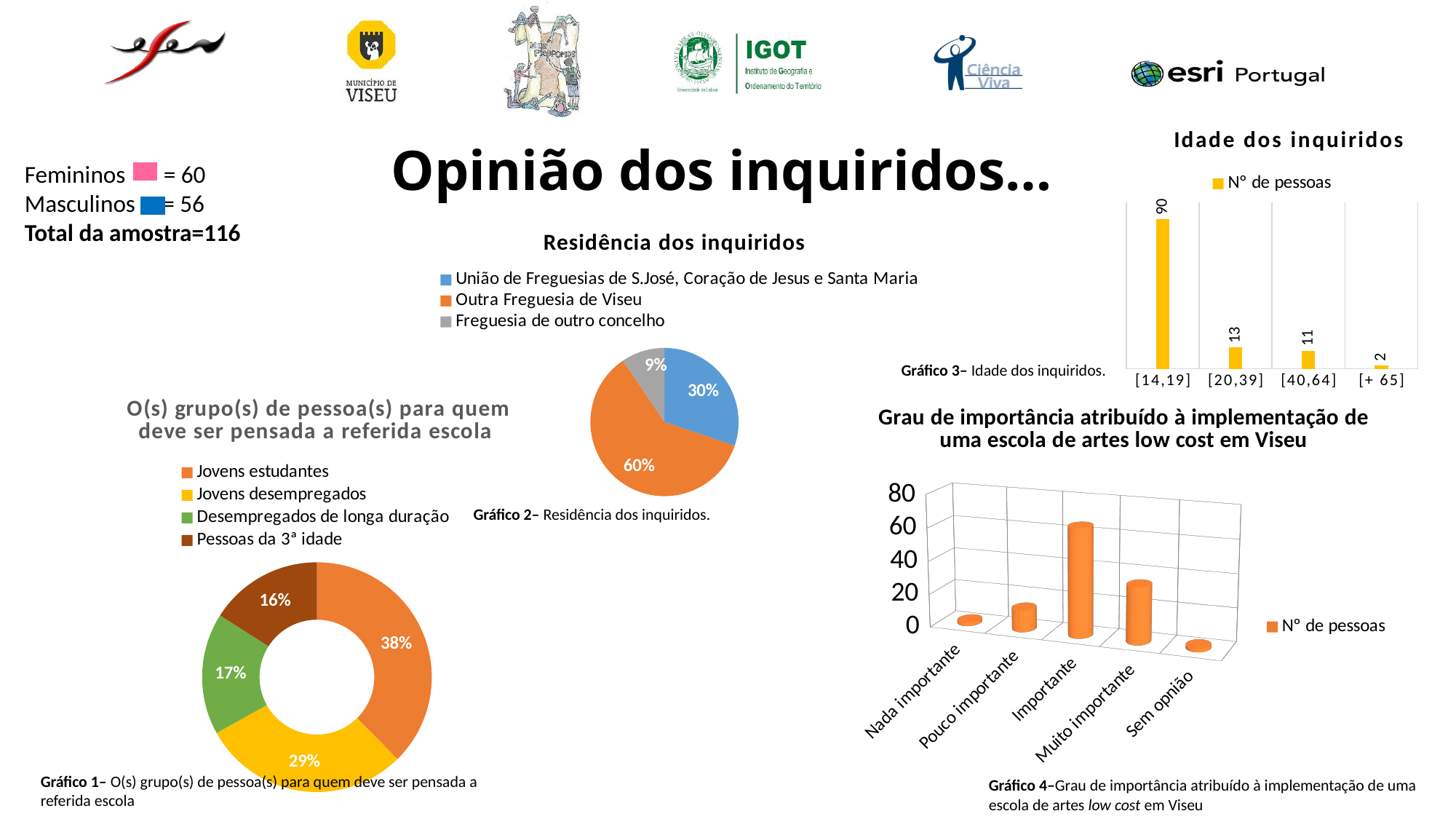
In the 'Grau de importância' chart, is the value for 'Importante' greater or less than 40? greater In the donut chart 'O(s) grupo(s) de pessoa(s) para quem deve ser pensada a referida escola', what is the share for 'Jovens desempregados'? 29% In the donut chart 'O(s) grupo(s) de pessoa(s) para quem deve ser pensada a referida escola', which is larger: 'Desempregados de longa duração' or 'Pessoas da 3ª idade'? Desempregados de longa duração In the 'Idade dos inquiridos' chart, which age group has the lowest number of people? [+ 65] In the 'Idade dos inquiridos' chart, how many age groups are shown? 4 In the 'Idade dos inquiridos' chart, what is the value for the [14,19] age group? 90 In the 'Residência dos inquiridos' pie chart, what share is 'Outra Freguesia de Viseu'? 60% In the 'Idade dos inquiridos' chart, what is the difference between the [20,39] and [40,64] groups? 2 In the 'Grau de importância' chart, which category has the highest value? Importante In the 'Residência dos inquiridos' pie chart, which category has the smallest slice? Freguesia de outro concelho In the donut chart 'O(s) grupo(s) de pessoa(s) para quem deve ser pensada a referida escola', which group has the largest share? Jovens estudantes In the 'Residência dos inquiridos' pie chart, what is the difference between 'Outra Freguesia de Viseu' and 'União de Freguesias de S.José, Coração de Jesus e Santa Maria'? 30%